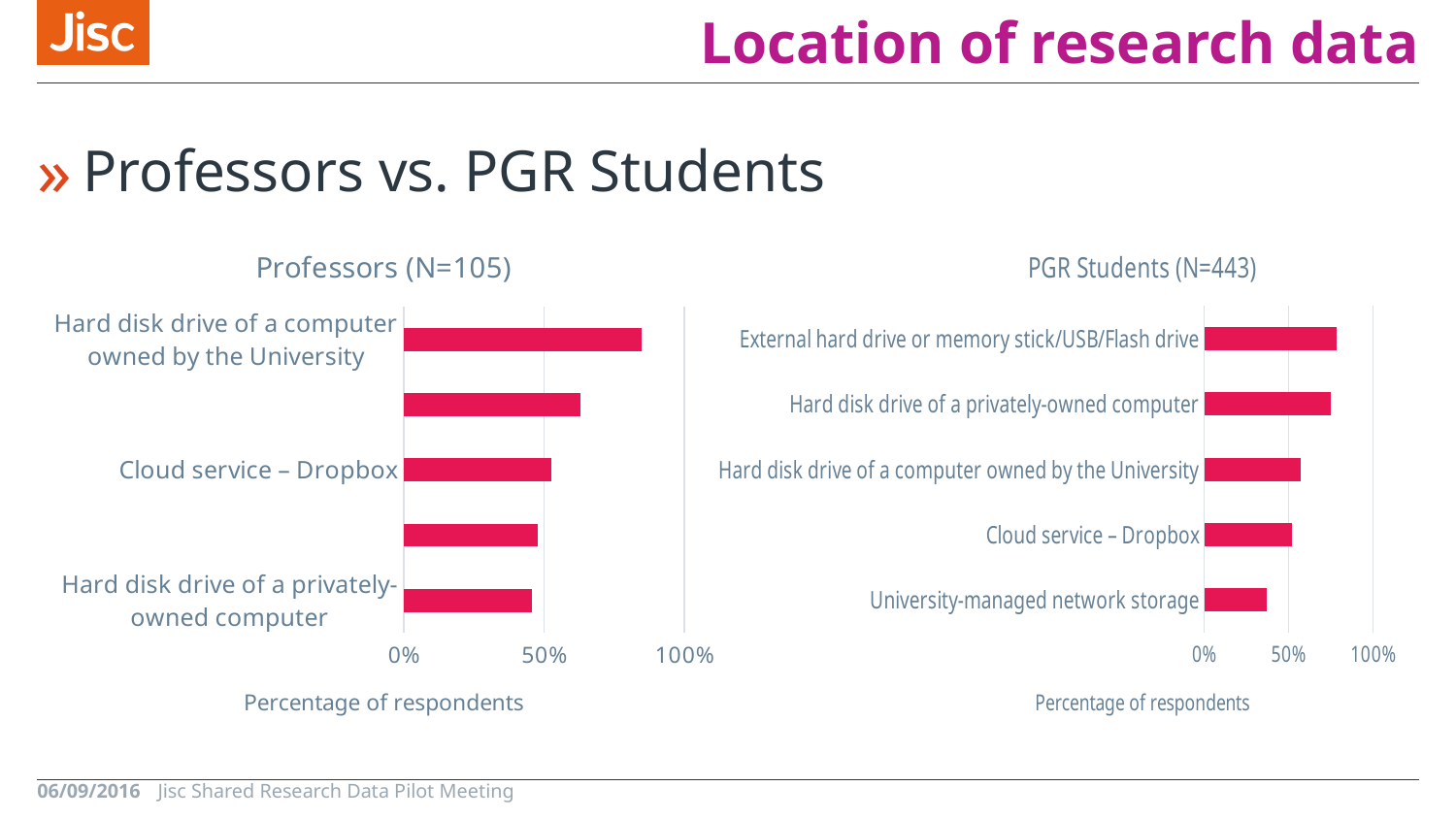
What is the sample size (N) shown in the title of the Professors chart? 105 What is the x-axis title of the PGR Students (N=443) chart? Percentage of respondents In the Professors (N=105) chart, is the value for Hard disk drive of a computer owned by the University greater or less than 50%? greater In the Professors (N=105) chart, which is larger: Hard disk drive of a computer owned by the University or Cloud service – Dropbox? Hard disk drive of a computer owned by the University In the PGR Students (N=443) chart, which is larger: Hard disk drive of a computer owned by the University or University-managed network storage? Hard disk drive of a computer owned by the University In the PGR Students (N=443) chart, which category has the lowest value? University-managed network storage How many bars are plotted in the PGR Students (N=443) chart? 5 In the Professors (N=105) chart, is the value for Hard disk drive of a privately-owned computer greater or less than 50%? less In the PGR Students (N=443) chart, is the value for University-managed network storage greater or less than 50%? less In the Professors (N=105) chart, which category has the highest value? Hard disk drive of a computer owned by the University What kind of chart is the Professors (N=105) chart? bar chart